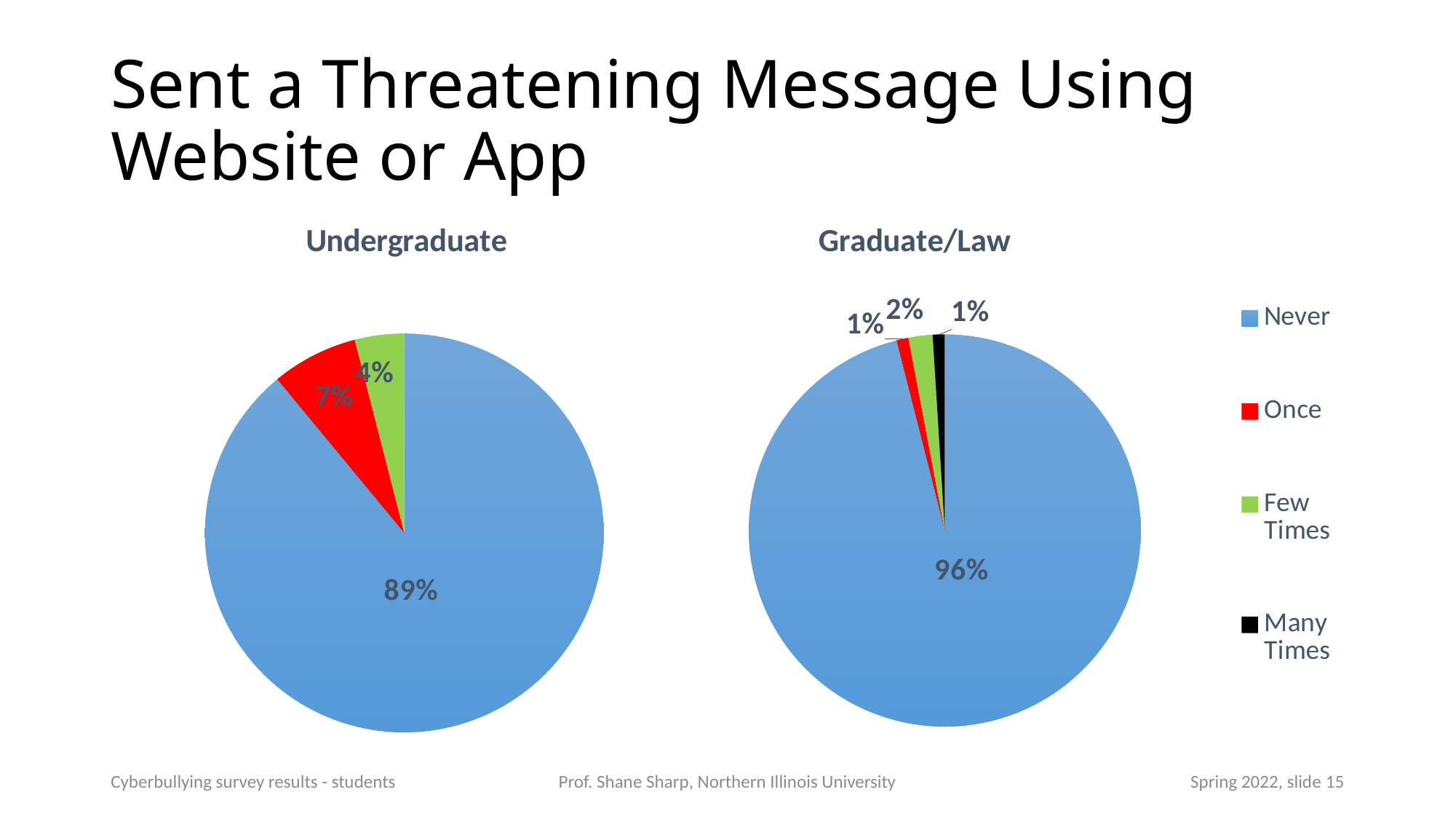
In the Undergraduate pie chart, what percentage of respondents answered Few Times? 4% In the Undergraduate pie chart, which category has the largest share? Never In the Undergraduate pie chart, what percentage of respondents answered Never? 89% In the Graduate/Law pie chart, what percentage of respondents answered Few Times? 2% What is the difference between the Never share in the Graduate/Law chart and the Never share in the Undergraduate chart? 7% In the Graduate/Law pie chart, what percentage of respondents answered Never? 96% Which chart has the larger share for Once, Undergraduate or Graduate/Law? Undergraduate In the Graduate/Law pie chart, what percentage of respondents answered Many Times? 1% What type of chart is used for the Undergraduate and Graduate/Law data? Pie chart How many categories does the legend list? 4 In the Undergraduate pie chart, what percentage of respondents answered Once? 7%